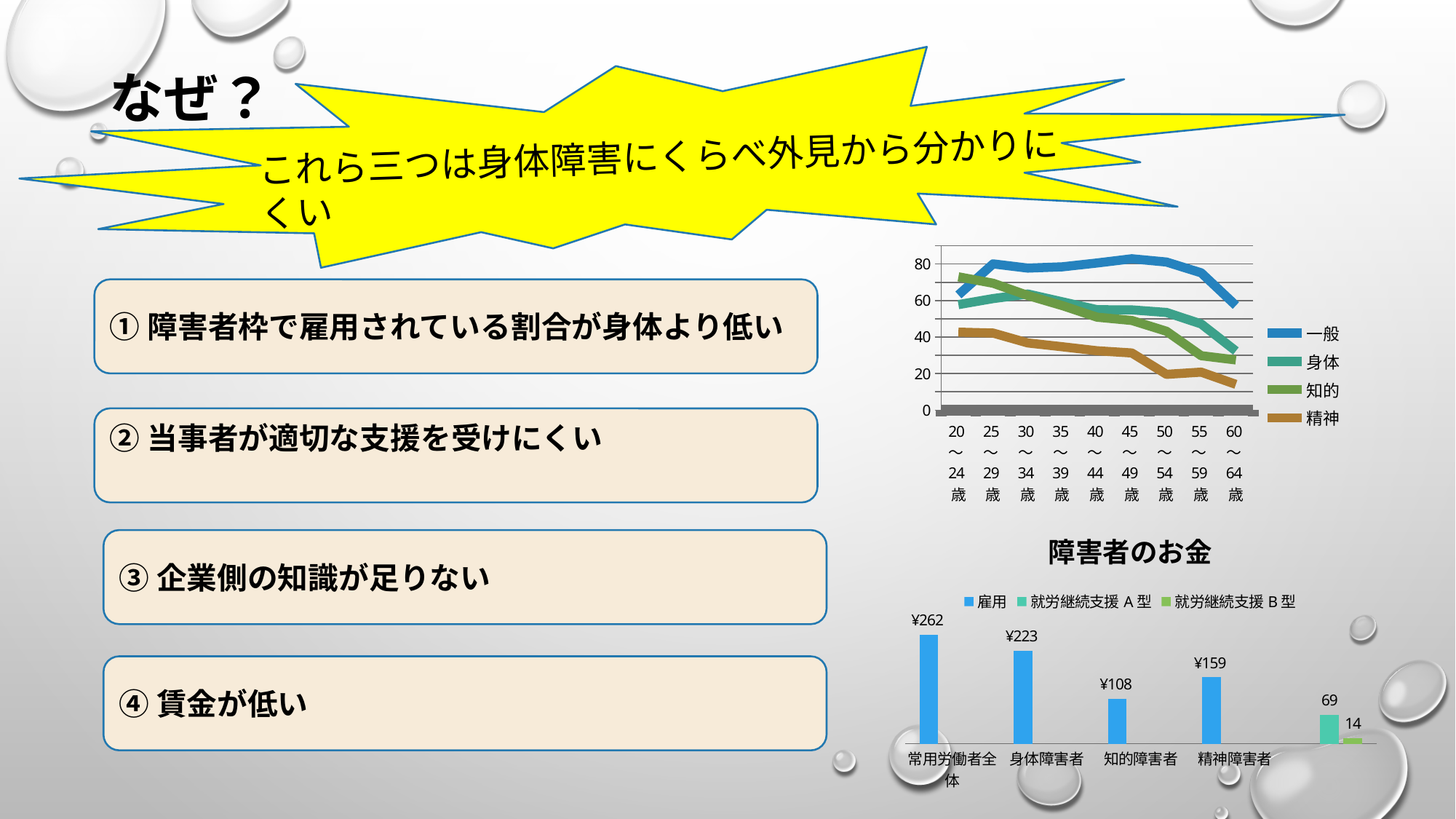
In the chart titled 障害者のお金, what is the value for 精神障害者 in the 雇用 series? ¥159 In the chart titled 障害者のお金, which is larger: the 雇用 value for 精神障害者 or for 知的障害者? 精神障害者 In the chart titled 障害者のお金, what is the value shown for the 就労継続支援 A 型 series? 69 In the line chart in the top right, how many series does the legend list? 4 In the chart titled 障害者のお金, which labelled category has the highest 雇用 value? 常用労働者全体 In the line chart in the top right, is the value for 精神 at 60〜64歳 greater or less than 20? less In the chart titled 障害者のお金, what is the difference between the 雇用 values for 身体障害者 and 知的障害者? ¥115 In the chart titled 障害者のお金, what is the value for 常用労働者全体 in the 雇用 series? ¥262 What kind of chart is the one in the top right of the slide? Line chart In the line chart in the top right, does the 精神 series generally rise or fall across the age groups? Fall In the chart titled 障害者のお金, what is the value for 知的障害者 in the 雇用 series? ¥108 In the chart titled 障害者のお金, how many series does the legend list? 3